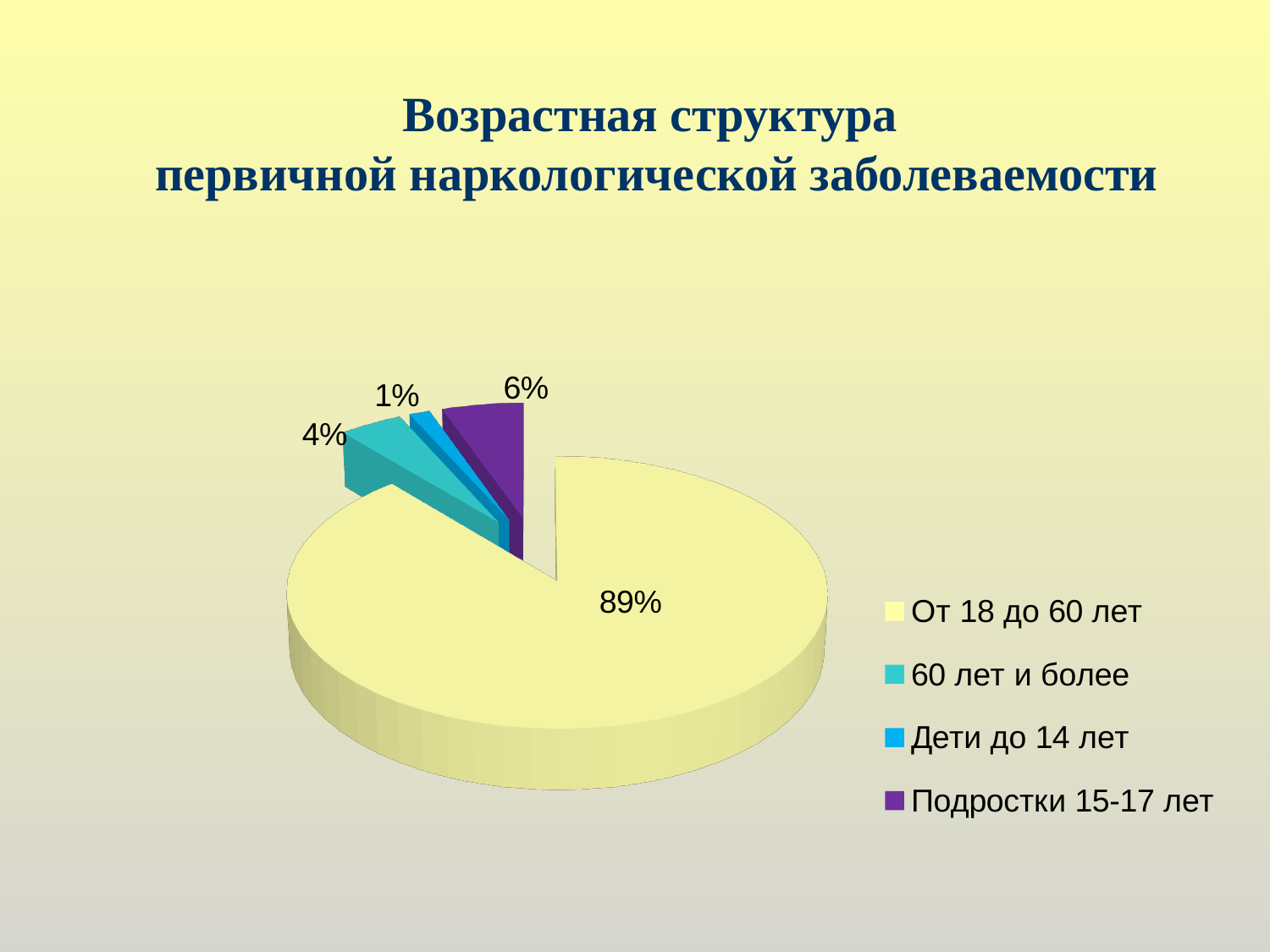
What colour is the "Подростки 15-17 лет" slice? purple What share of the pie does the "Дети до 14 лет" slice have? 1% Which is larger: the share for "60 лет и более" or the share for "Подростки 15-17 лет"? Подростки 15-17 лет What share of the pie does the "60 лет и более" slice have? 4% Which category has the largest slice of the pie? От 18 до 60 лет What is the title of the chart on the slide? Возрастная структура первичной наркологической заболеваемости What share of the pie does the "От 18 до 60 лет" slice have? 89% What kind of chart is shown on the slide? pie chart Which category has the smallest slice of the pie? Дети до 14 лет How many categories does the legend list? 4 What is the difference in percentage points between the "Подростки 15-17 лет" slice and the "60 лет и более" slice? 2